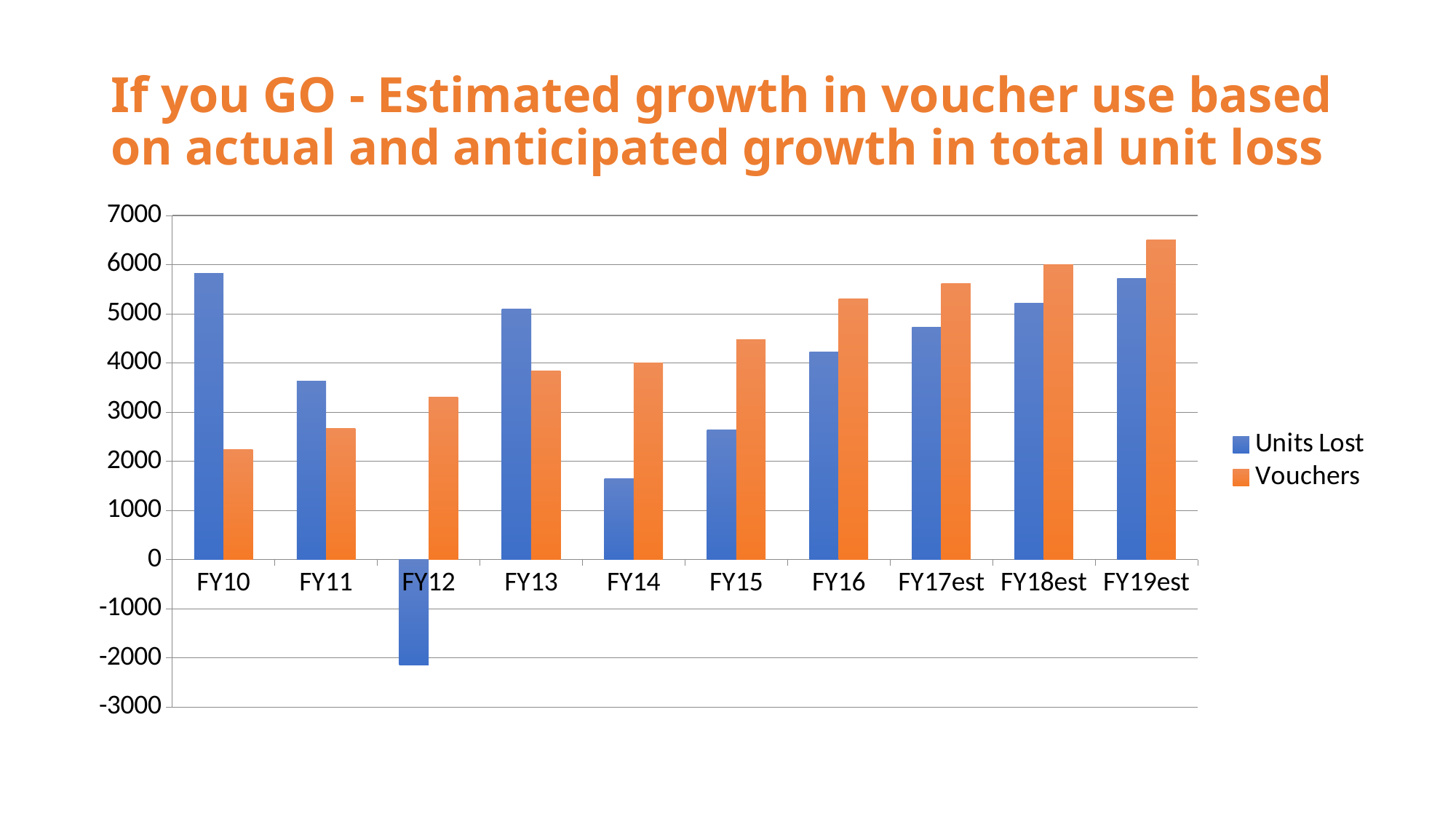
How many fiscal year categories are shown on the x axis? 10 How many series does the legend list? 2 Is the Units Lost value for FY12 greater or less than -1000? less Which fiscal year has the lowest Vouchers value? FY10 What kind of chart is shown on the slide? bar chart Do the Vouchers values rise or fall from FY10 to FY19est? rise Which fiscal year has the highest Vouchers value? FY19est In FY16, which is larger: Units Lost or Vouchers? Vouchers Is the Units Lost value for FY14 greater or less than 2000? less Which fiscal year has the lowest Units Lost value? FY12 Is the Vouchers value for FY19est greater or less than 6000? greater In FY10, which is larger: Units Lost or Vouchers? Units Lost